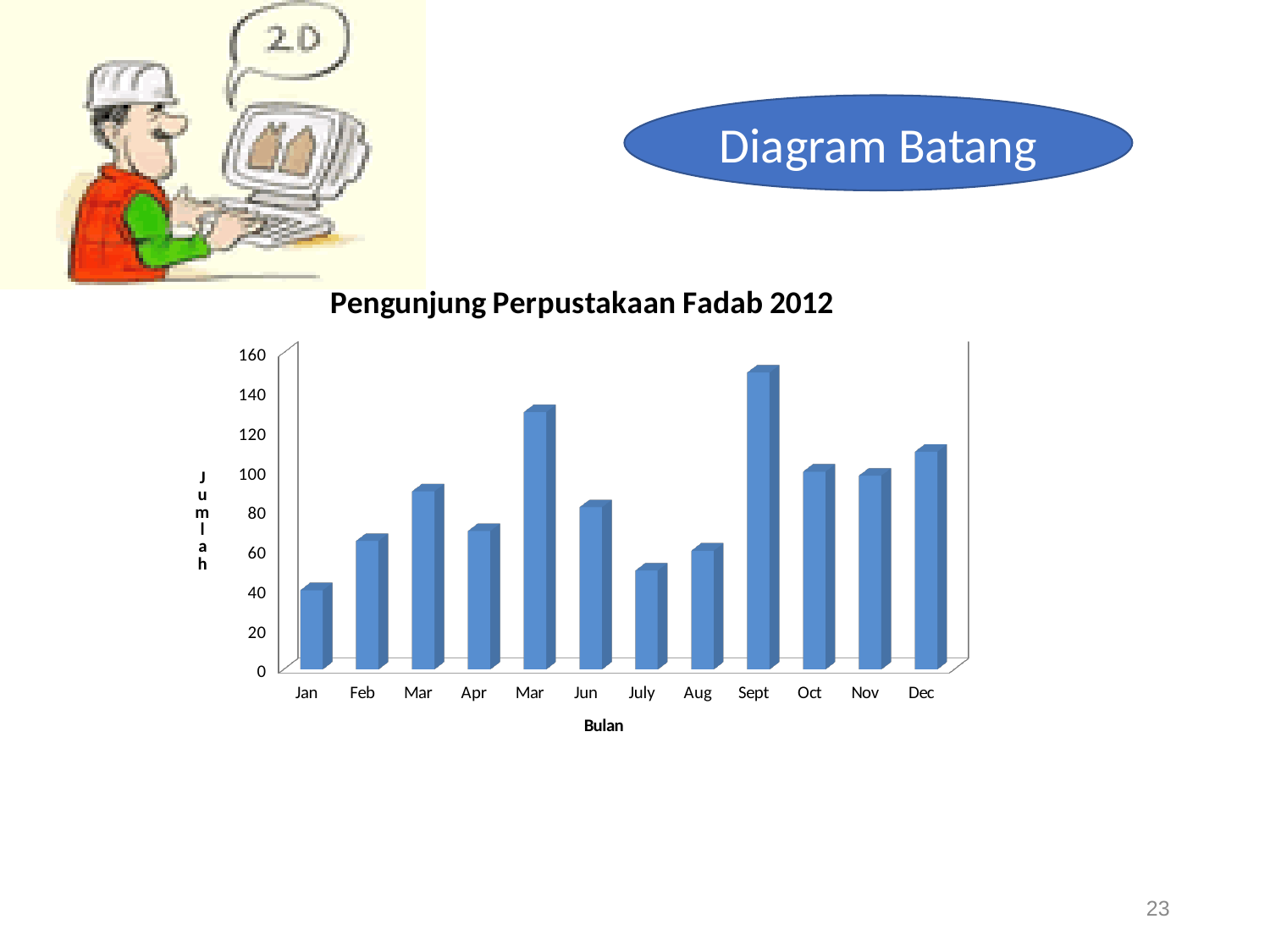
Which month has the lowest number of visitors? Jan What is the title of the chart? Pengunjung Perpustakaan Fadab 2012 Which is larger, the value for Feb or the value for Jan? Feb What is the label on the x axis of the chart? Bulan What type of chart is shown on the slide? Bar chart Is the value for Jan greater or less than 60? less Is the value for Dec greater or less than 100? greater Is the value for Sept greater or less than 140? greater How many months (categories) are shown on the x axis? 12 Which is larger, the value for Sept or the value for Dec? Sept Which month has the highest number of visitors? Sept